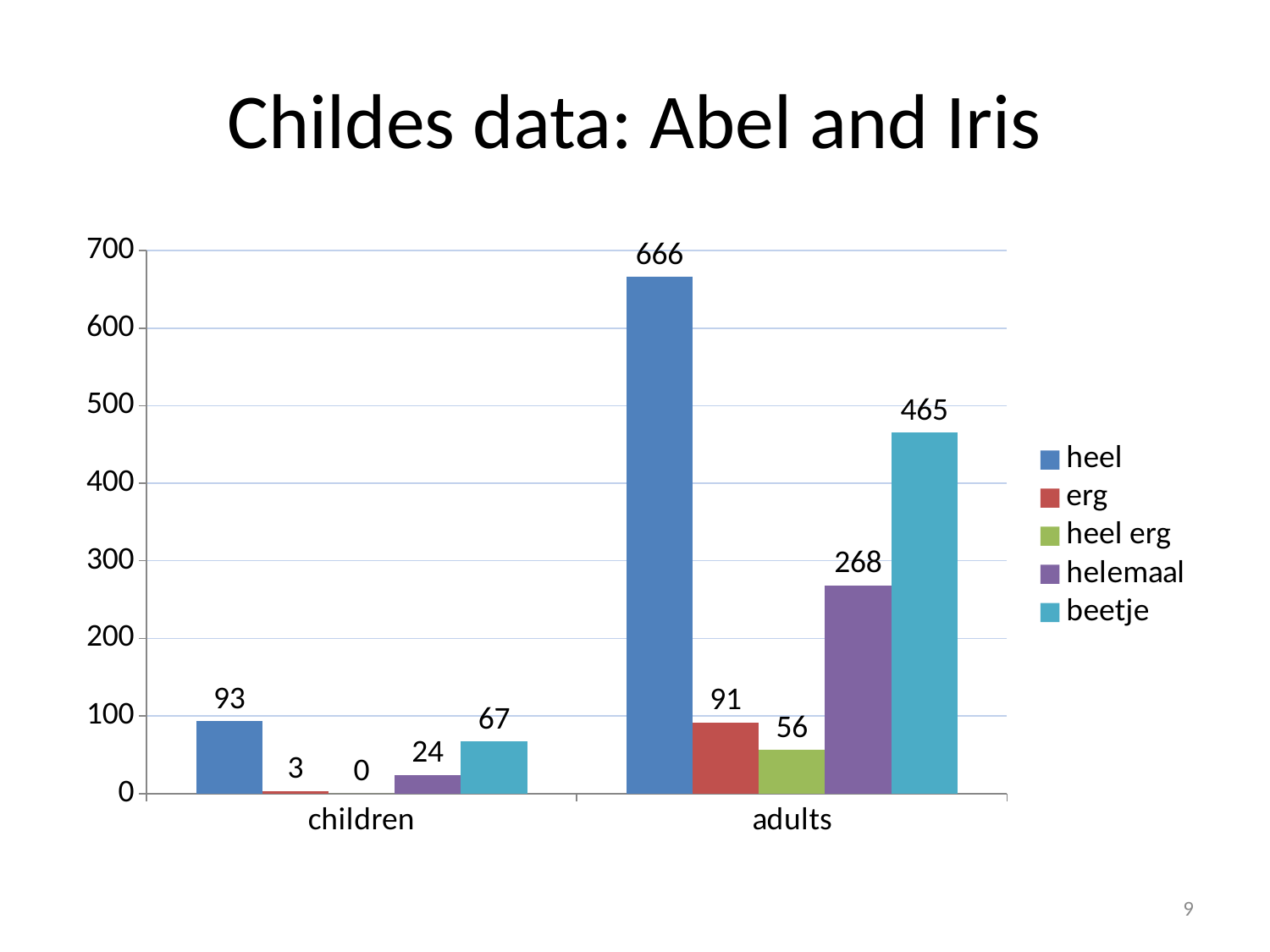
How many series does the legend list? 5 What is the value for 'erg' in the 'children' group? 3 What is the title of the slide? Childes data: Abel and Iris What is the value for 'helemaal' in the 'children' group? 24 What is the value for 'heel' in the 'adults' group? 666 What is the difference between the 'heel' values for adults and children? 573 Which series has the lowest value in the 'children' group? heel erg Which is larger: 'helemaal' for adults or 'beetje' for adults? beetje for adults What is the value for 'beetje' in the 'adults' group? 465 How many categories are shown on the x axis? 2 What kind of chart is shown on the slide? bar chart Which series has the highest value in the 'adults' group? heel